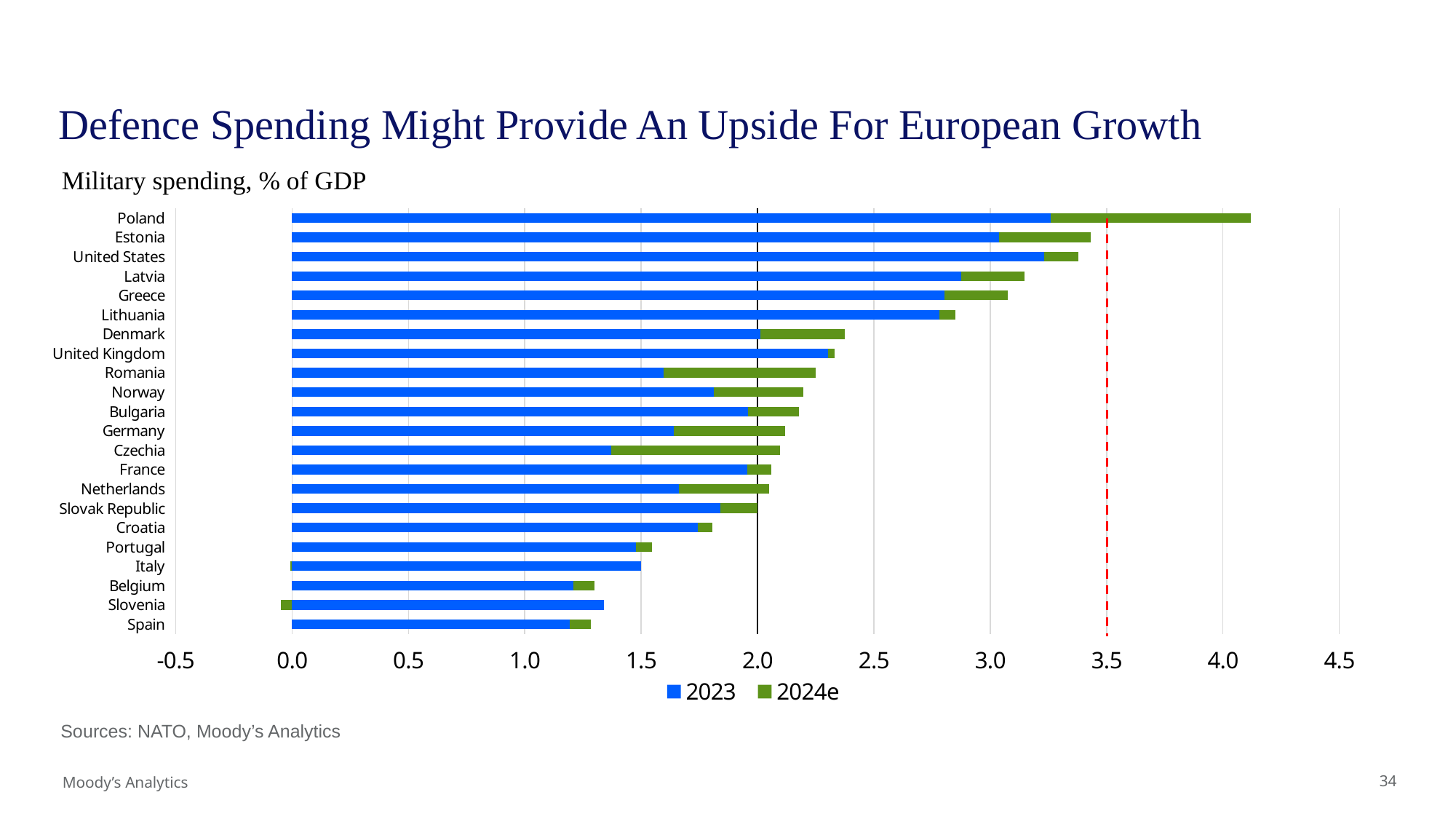
What kind of chart is shown on the slide? Bar chart How many series does the legend list? 2 Is the 2023 value for Spain greater or less than 1.5? less Is the 2023 value for Poland greater or less than 3.0? greater Which has the longer total bar, Poland or Estonia? Poland Is the total bar for Estonia greater or less than 3.5? less Which series is shown in green? 2024e Which has the larger 2023 value, Romania or Norway? Norway Do the bar lengths generally increase or decrease going from the top of the chart to the bottom? decrease How many countries are shown on the chart? 22 Which country has the longest bar (highest total military spending as % of GDP)? Poland